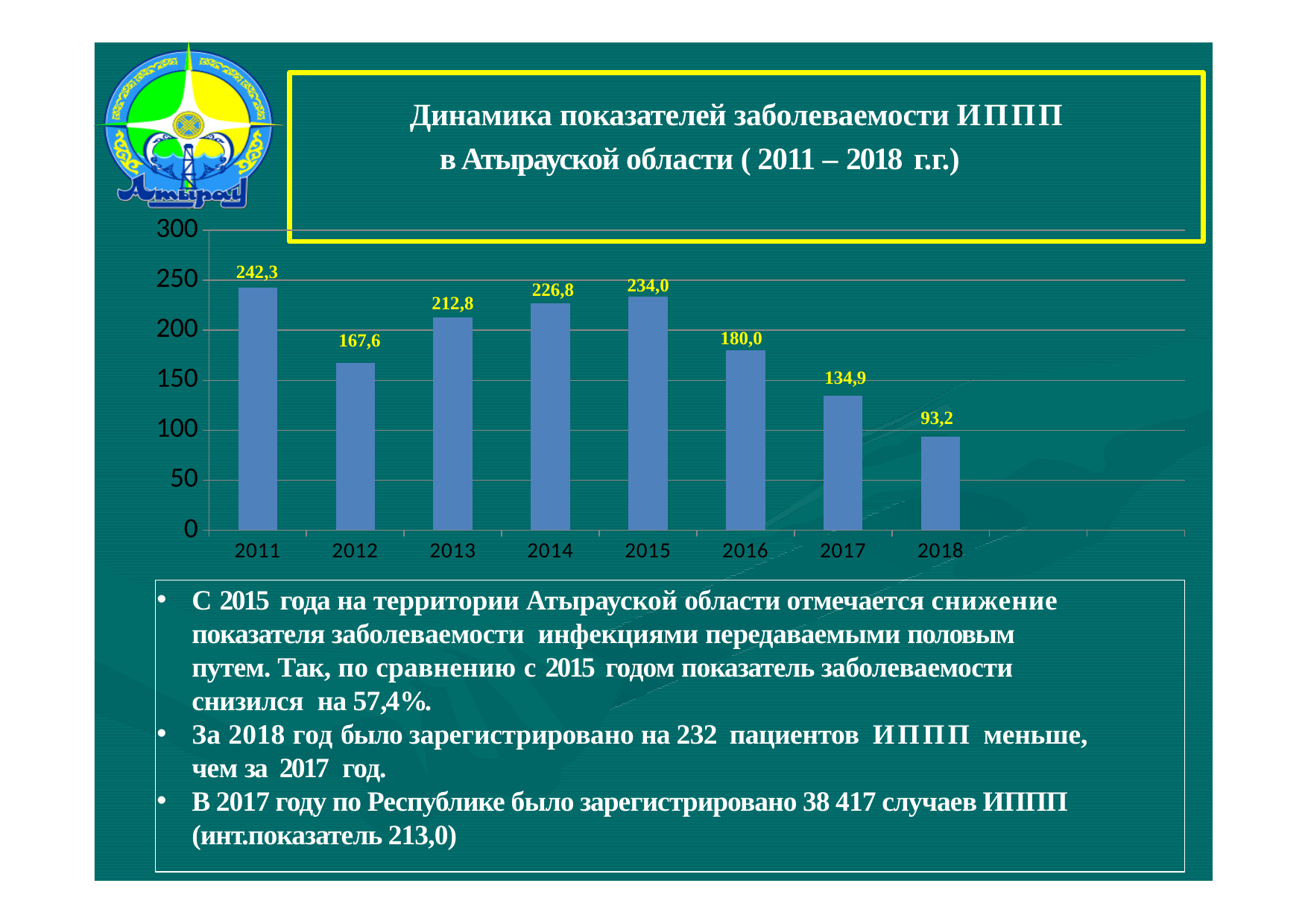
What is the value for 2016? 180,0 What is the value for 2011? 242,3 Which year has the lowest value? 2018 Do the values rise or fall from 2015 to 2018? Fall How many years are shown on the x axis? 8 Is the value for 2013 greater or less than 200? greater What kind of chart is shown on the slide? Bar chart Which is larger, the value for 2014 or the value for 2015? 2015 What is the value for 2018? 93,2 What is the difference between the values for 2017 and 2018? 41,7 Which year has the highest value? 2011 What is the difference between the values for 2015 and 2018? 140,8